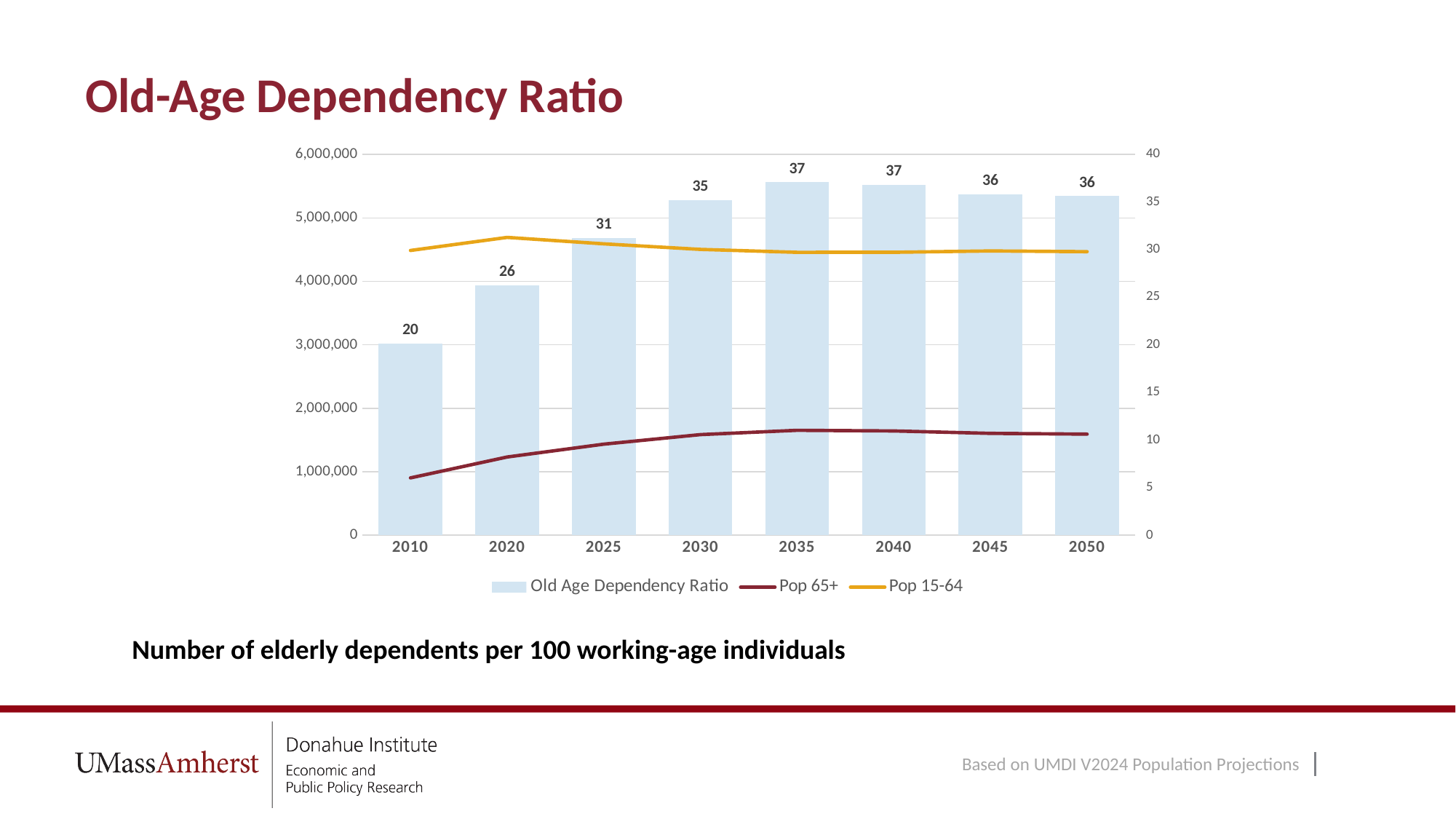
Which year has a higher Old Age Dependency Ratio, 2020 or 2030? 2030 Is the Pop 65+ value in 2035 greater or less than 1,000,000? greater How many years are shown on the x axis of the chart? 8 Which year has the lowest Old Age Dependency Ratio? 2010 Is the Pop 15-64 value in 2020 greater or less than 4,000,000? greater What is the Old Age Dependency Ratio value shown for 2010? 20 By how much does the Old Age Dependency Ratio in 2050 exceed the value in 2010? 16 What is the title of the chart on the slide? Old-Age Dependency Ratio Does the Old Age Dependency Ratio rise or fall from 2010 to 2035? rise What is the Old Age Dependency Ratio value shown for 2050? 36 What is the Old Age Dependency Ratio value shown for 2025? 31 How many series does the legend list? 3